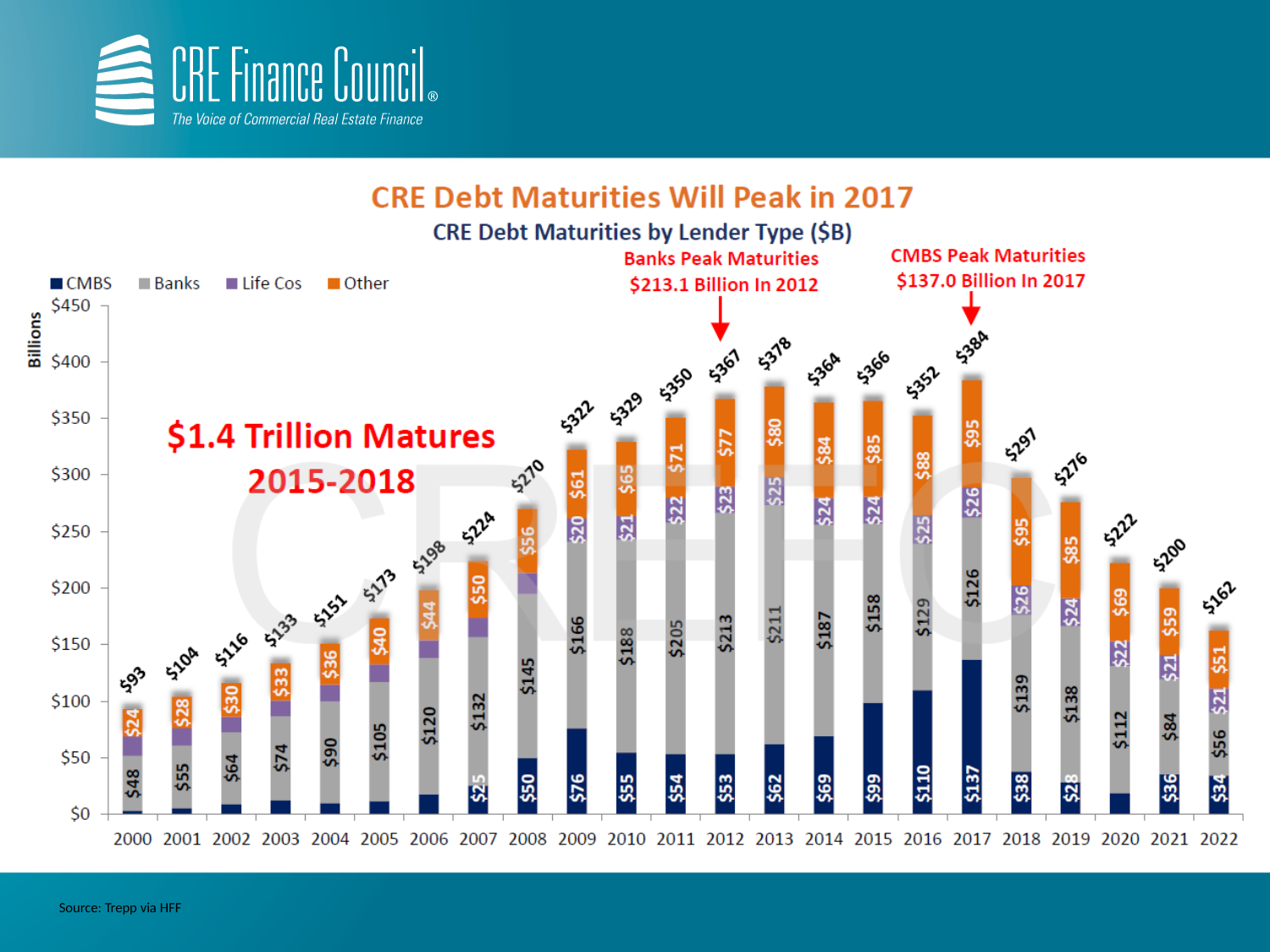
What is the total CRE debt maturities value shown for 2017? $384 What kind of chart is shown on the slide? Stacked bar chart What is the Banks value for 2012? $213 What is the CMBS value for 2017? $137 Which is larger, the Banks value for 2013 or the Banks value for 2014? 2013 Which year has the lowest total CRE debt maturities? 2000 What is the Other value for 2014? $84 Do the total CRE debt maturities rise or fall from 2017 to 2022? Fall Which year has the highest total CRE debt maturities? 2017 What is the difference between the total for 2017 and the total for 2018? $87 How many series does the legend list? 4 How many years are shown on the x axis? 23